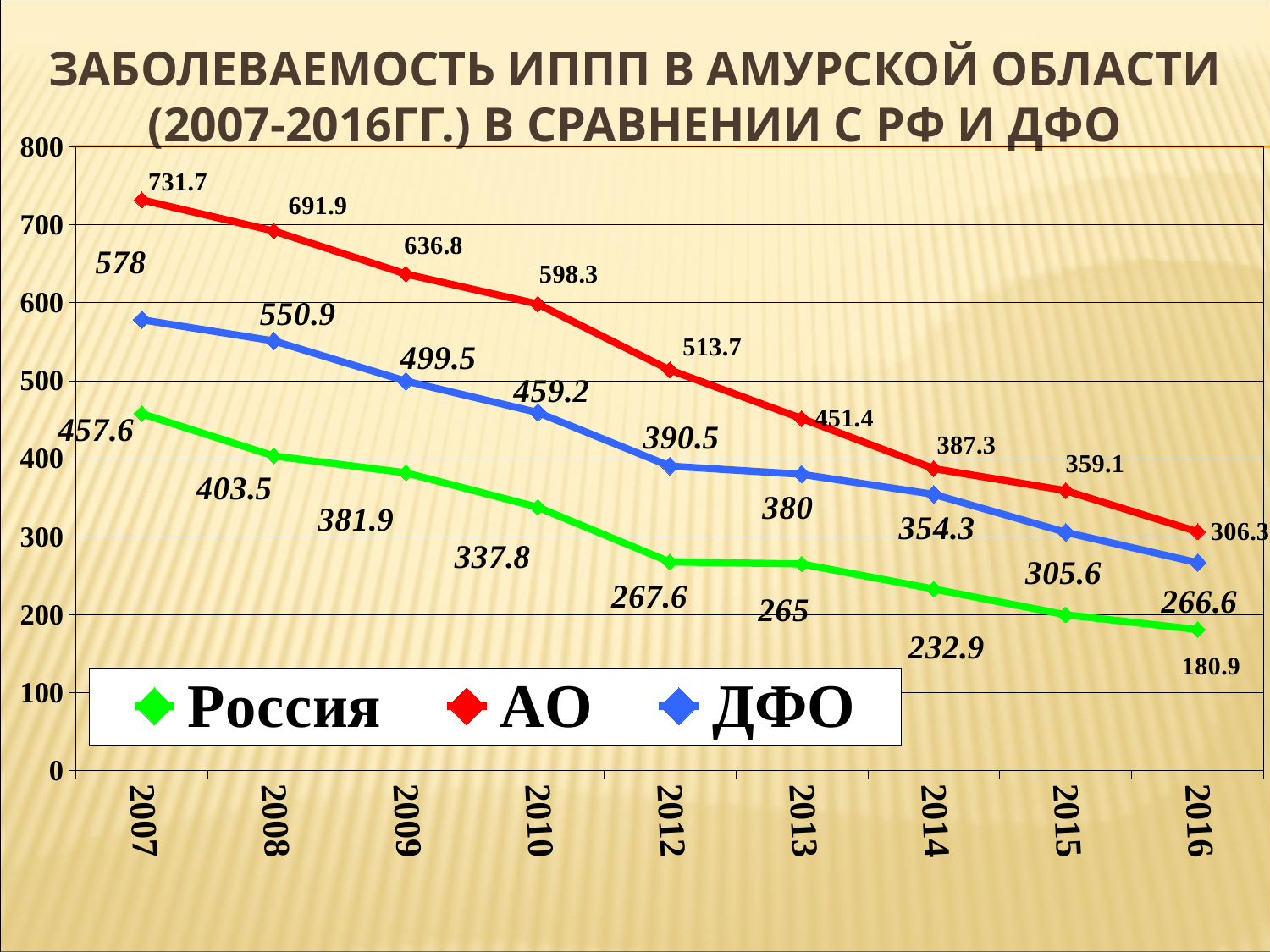
What is the value for ДФО in 2012? 390.5 What is the value for АО in 2007? 731.7 How many series does the legend list? 3 What is the difference between the АО values in 2007 and 2016? 425.4 In which year is the value for ДФО lowest? 2016 How many years are shown on the x axis? 9 In 2013, which series has the larger value, АО or ДФО? АО What is the value for Россия in 2016? 180.9 What kind of chart is shown on the slide? line chart In which year is the value for АО highest? 2007 What is the difference between the ДФО and Россия values in 2007? 120.4 Is the value for Россия in 2015 greater or less than 300? less